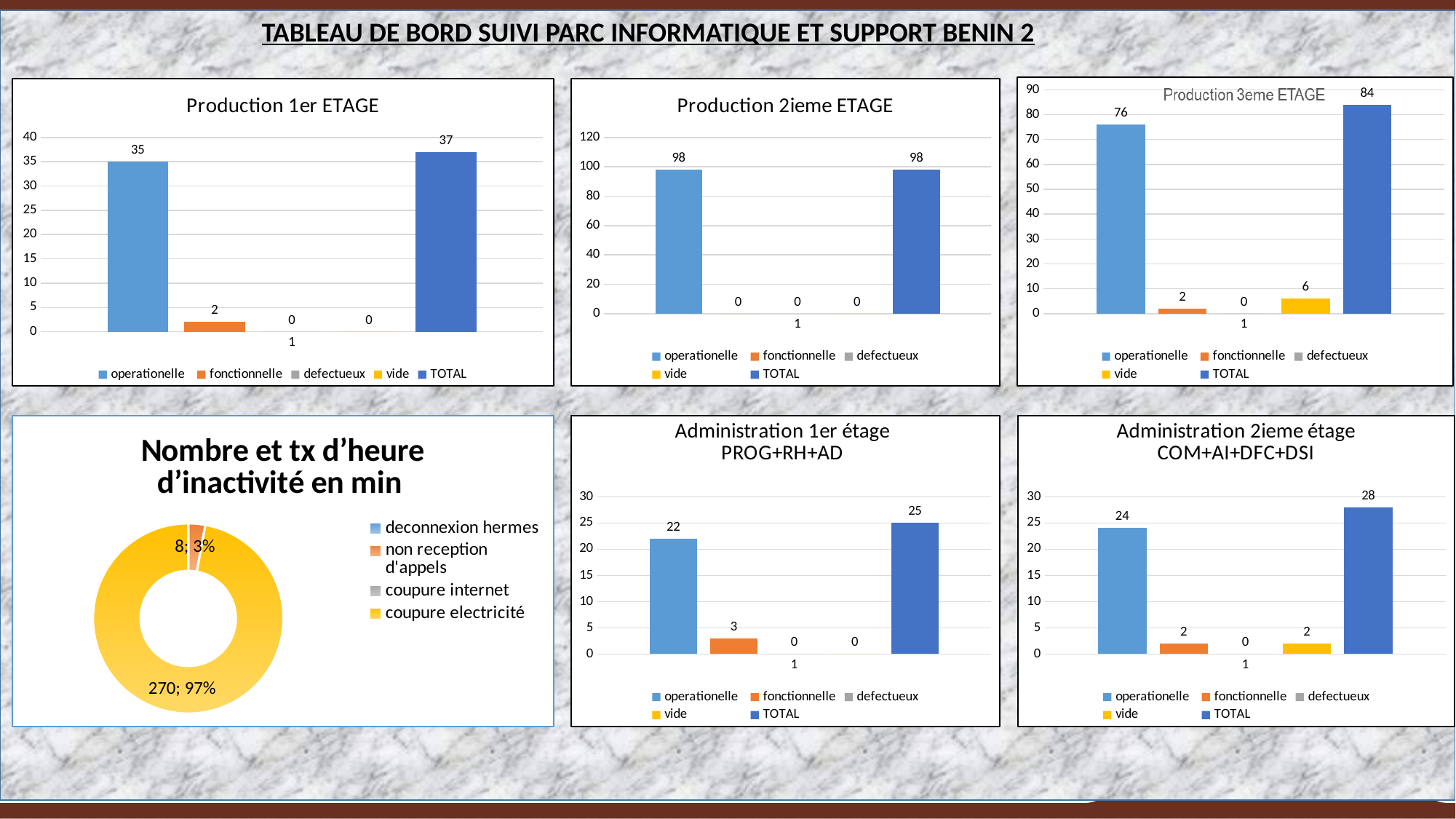
What kind of chart is 'Nombre et tx d'heure d'inactivité en min'? Doughnut chart In the 'Production 3eme ETAGE' chart, what is the difference between TOTAL and operationelle? 8 In the 'Production 3eme ETAGE' chart, what is the value for vide? 6 In the 'Production 1er ETAGE' chart, what is the value for operationelle? 35 How many series does the legend of the 'Production 1er ETAGE' chart list? 5 In the 'Nombre et tx d'heure d'inactivité en min' chart, what is the value for non reception d'appels? 8 In the 'Administration 2ieme étage COM+AI+DFC+DSI' chart, is the value for operationelle larger than the value for vide? Yes In the 'Nombre et tx d'heure d'inactivité en min' chart, what share does coupure electricité have? 97% In the 'Administration 1er étage PROG+RH+AD' chart, what is the value for fonctionnelle? 3 In the 'Administration 2ieme étage COM+AI+DFC+DSI' chart, which series has the highest value? TOTAL In the 'Production 1er ETAGE' chart, what is the value for TOTAL? 37 In the 'Production 2ieme ETAGE' chart, what is the value for operationelle? 98